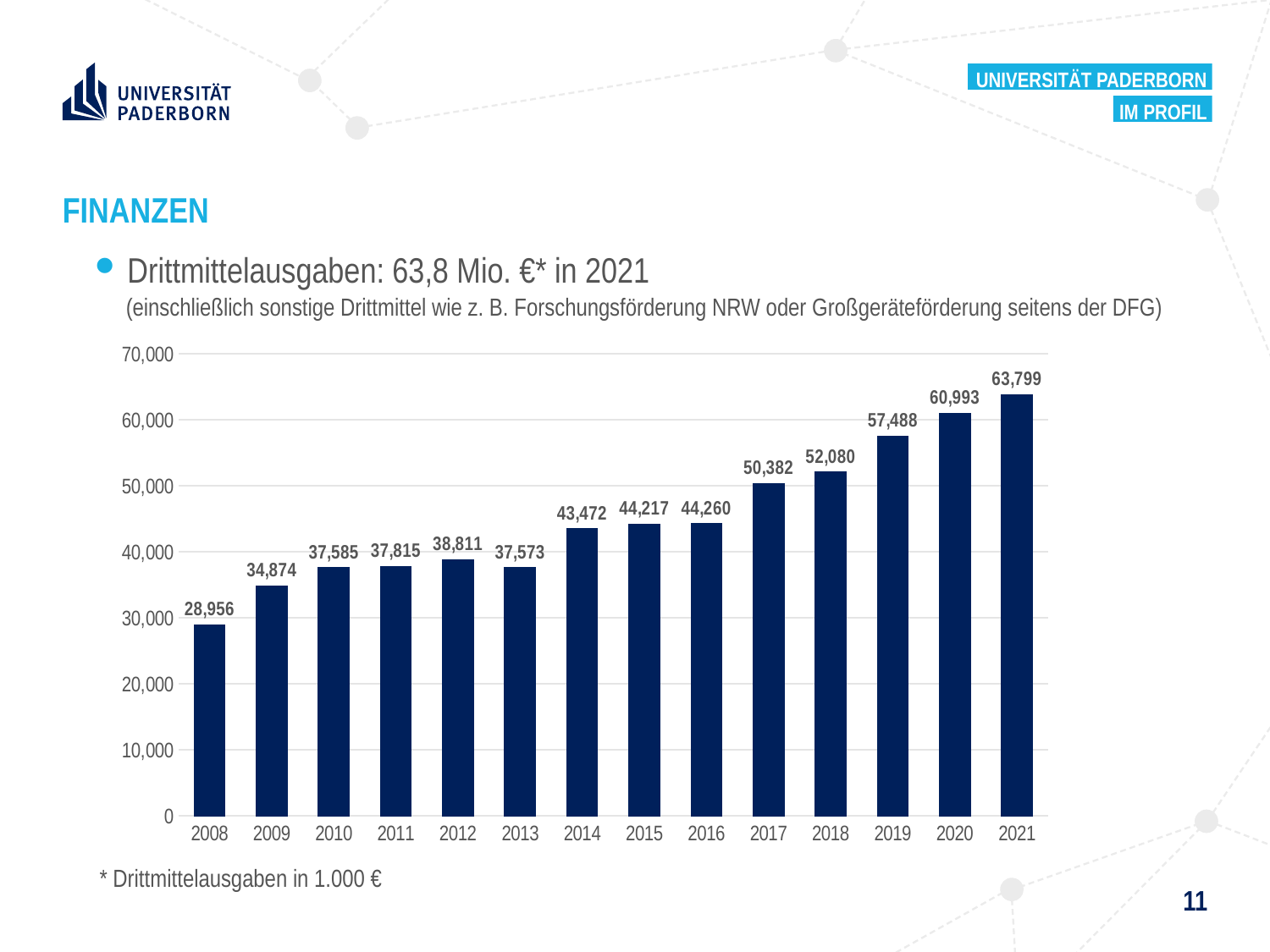
What kind of chart is shown on the slide? Bar chart Which year has the highest value? 2021 What is the difference between the values for 2021 and 2008? 34,843 Do the values generally rise or fall from 2008 to 2021? Rise Which year has the lowest value? 2008 Which year has the larger value, 2012 or 2013? 2012 What is the value shown for 2016? 44,260 What is the difference between the values for 2021 and 2020? 2,806 What is the value shown for 2021? 63,799 What is the value shown for 2008? 28,956 How many years are shown on the x axis? 14 Is the value for 2014 greater or less than 40,000? greater